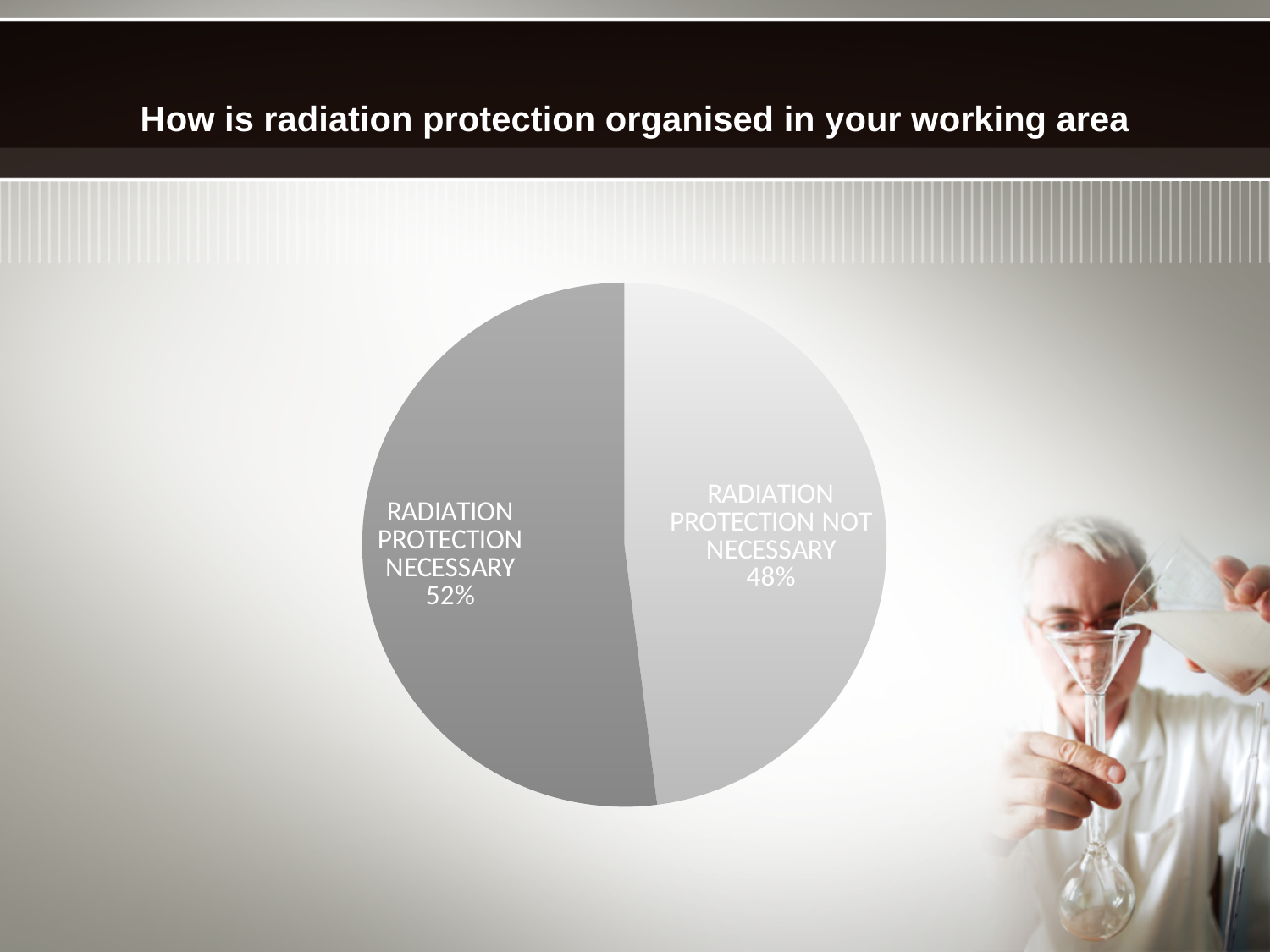
What share of the pie is labelled 'RADIATION PROTECTION NOT NECESSARY'? 48% Which slice of the pie is the largest? RADIATION PROTECTION NECESSARY Which slice of the pie is shaded in the darker grey? RADIATION PROTECTION NECESSARY What is the difference in percentage points between the 'RADIATION PROTECTION NECESSARY' and 'RADIATION PROTECTION NOT NECESSARY' slices? 4 percentage points What is the title shown above the chart on the slide? How is radiation protection organised in your working area Which is larger: the 'RADIATION PROTECTION NECESSARY' slice or the 'RADIATION PROTECTION NOT NECESSARY' slice? RADIATION PROTECTION NECESSARY How many slices does the pie chart have? 2 What share of the pie is labelled 'RADIATION PROTECTION NECESSARY'? 52% Is the share for 'RADIATION PROTECTION NECESSARY' greater or less than 50%? greater What kind of chart is shown on the slide? pie chart Which slice of the pie is the smallest? RADIATION PROTECTION NOT NECESSARY